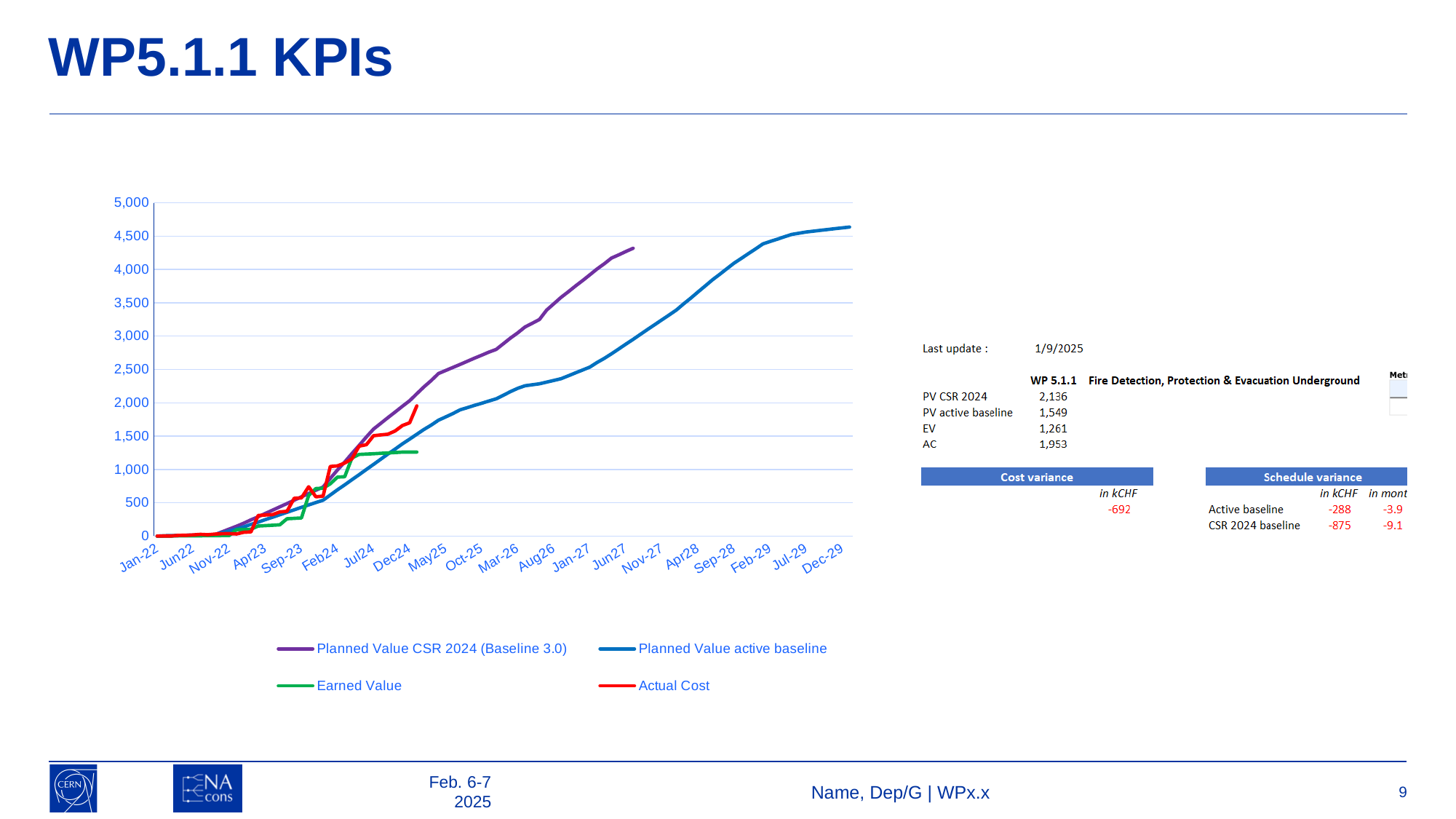
Which series reaches the highest value on the chart? Planned Value active baseline Which series ends earliest on the x axis, Planned Value CSR 2024 (Baseline 3.0) or Planned Value active baseline? Planned Value CSR 2024 (Baseline 3.0) What is the highest value shown on the chart's y axis? 5,000 Is the final value of the Actual Cost line greater or less than 1,500? greater How many series does the chart legend list? 4 What kind of chart is shown on the slide? line chart Is the final value of the Planned Value CSR 2024 (Baseline 3.0) line greater or less than 4,000? greater What colour is the Earned Value line in the legend? green Do the values of the Planned Value active baseline line rise or fall along the x axis? rise Is the final value of the Planned Value active baseline line (at Dec-29) greater or less than 4,500? greater At Dec24, which is higher: the Actual Cost line or the Earned Value line? Actual Cost